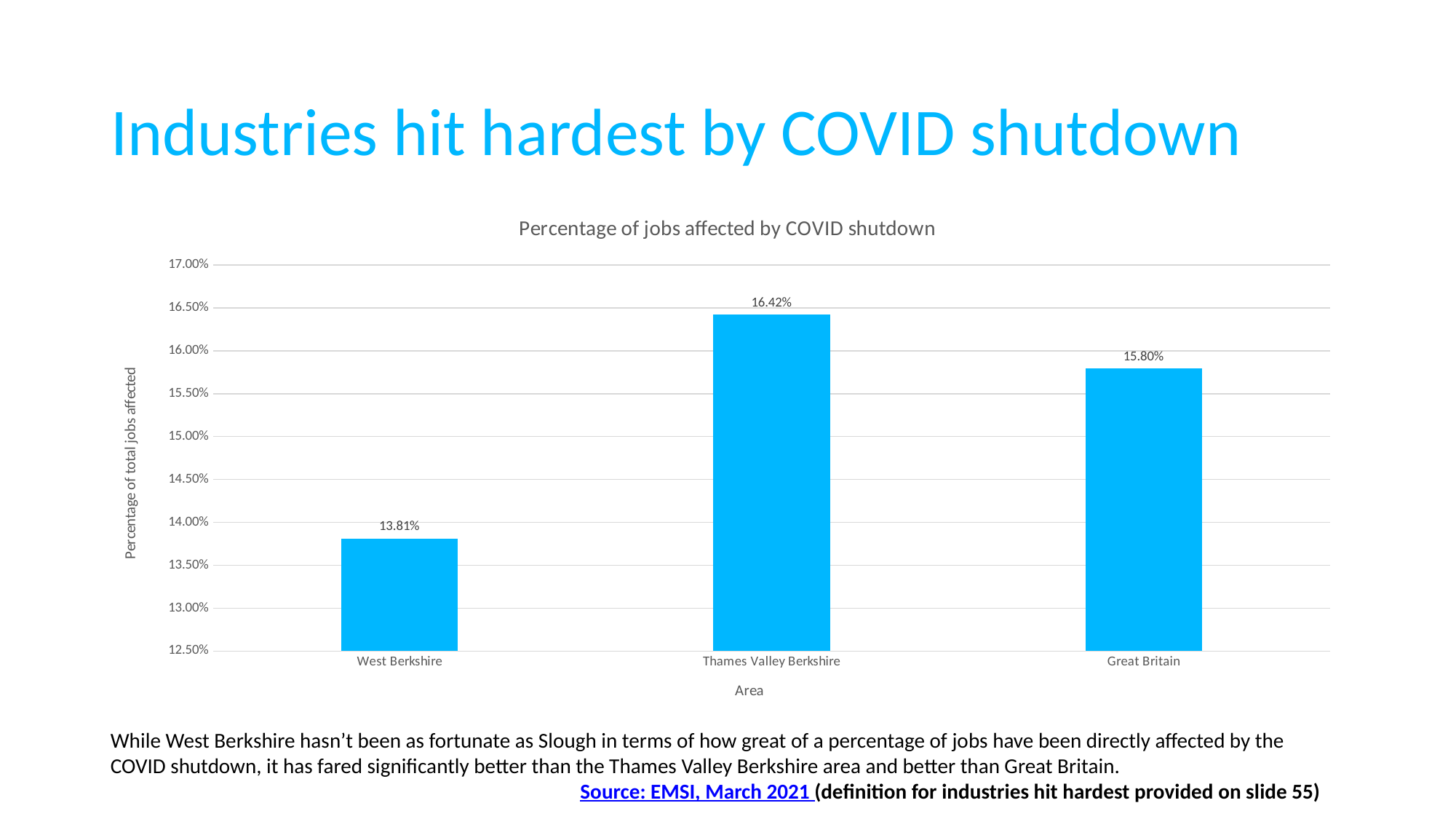
What is the difference between the percentage of jobs affected in Great Britain and West Berkshire? 1.99% What is the percentage of jobs affected by COVID shutdown for West Berkshire? 13.81% What is the difference between the percentage of jobs affected in Thames Valley Berkshire and West Berkshire? 2.61% What is the percentage of jobs affected by COVID shutdown for Great Britain? 15.80% What is the percentage of jobs affected by COVID shutdown for Thames Valley Berkshire? 16.42% What is the title of the chart? Percentage of jobs affected by COVID shutdown Which area has the lowest percentage of jobs affected by COVID shutdown? West Berkshire Which area has the highest percentage of jobs affected by COVID shutdown? Thames Valley Berkshire Which has a higher percentage of jobs affected by COVID shutdown, Great Britain or West Berkshire? Great Britain How many areas are shown in the chart? 3 What kind of chart is shown on the slide? Bar chart Is the value for West Berkshire greater or less than 14.00%? less